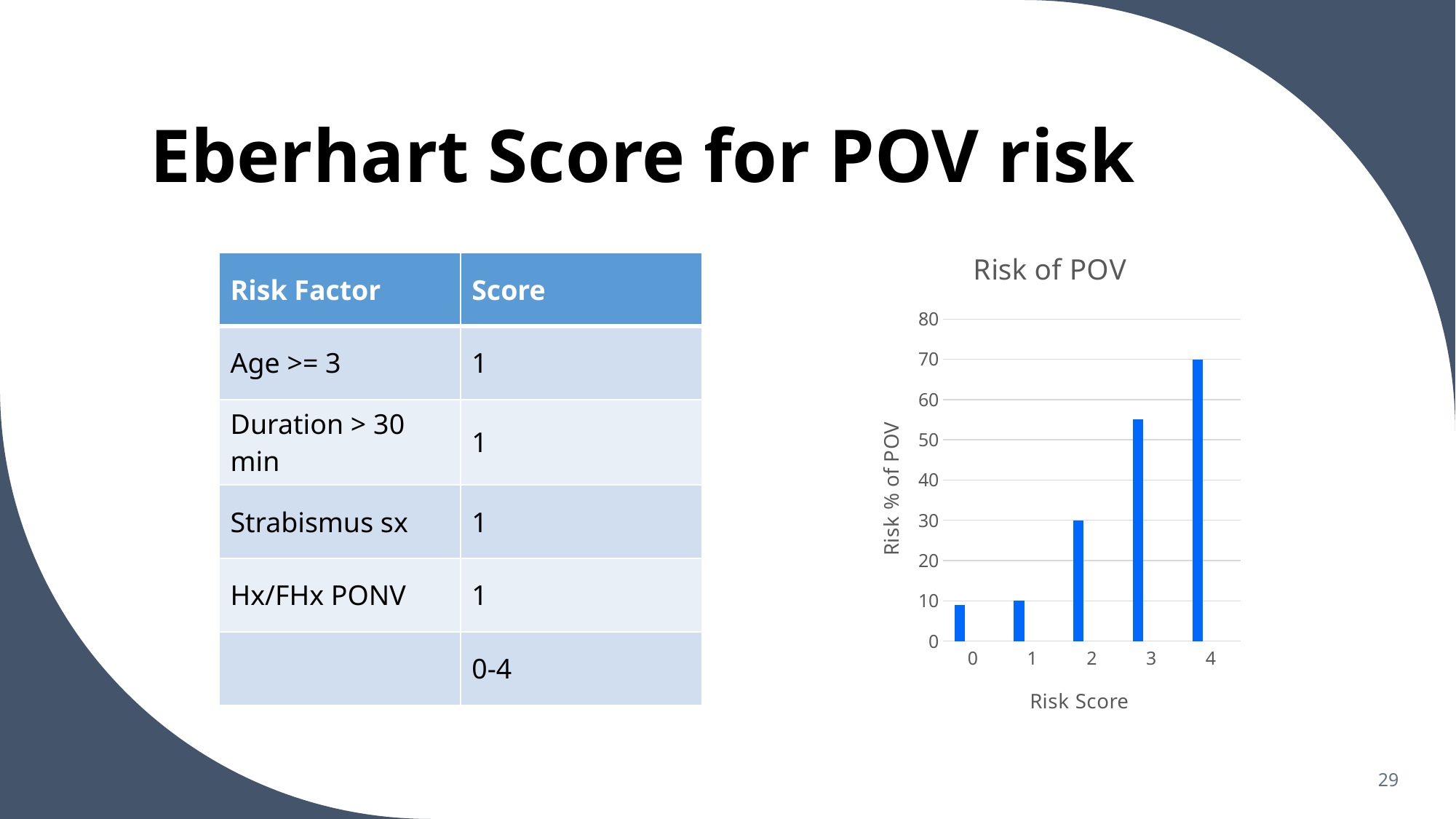
Which has a higher risk % of POV, a risk score of 2 or a risk score of 3? 3 What is the label of the y axis of the chart? Risk % of POV What is the title of the chart? Risk of POV What kind of chart is shown on the slide? bar chart What is the risk % of POV for a risk score of 2? 30 What is the risk % of POV for a risk score of 4? 70 Does the risk % of POV rise or fall as the risk score increases from 0 to 4? rise Is the risk % of POV for a risk score of 3 greater or less than 60? less How many risk score categories are plotted in the chart? 5 Is the risk % of POV for a risk score of 3 greater or less than 50? greater Which risk score has the highest risk % of POV? 4